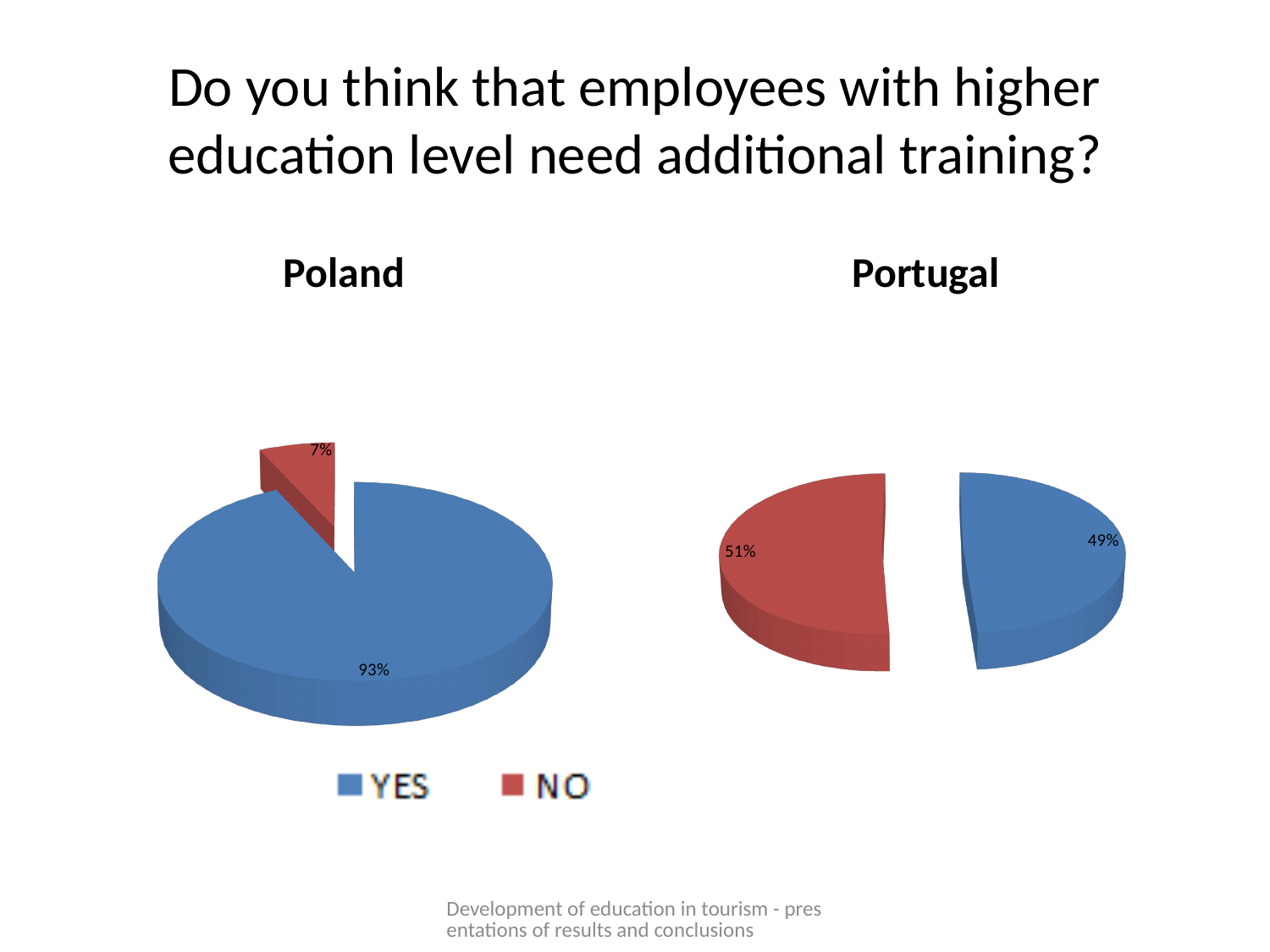
What colour represents the NO answer in the pie charts? Red In the Portugal pie chart, which answer has the smallest share? YES Which is larger: the YES share in the Poland chart or the YES share in the Portugal chart? Poland In the Poland pie chart, what is the difference between the YES and NO shares? 86% In the Poland pie chart, which answer has the largest share? YES In the Portugal pie chart, what is the difference between the NO and YES shares? 2% In the Poland pie chart, what percentage of respondents answered YES? 93% What type of chart is used for the Poland and Portugal data? Pie chart In the Portugal pie chart, what percentage of respondents answered YES? 49% How many categories does the legend list for the pie charts? 2 In the Portugal pie chart, what percentage of respondents answered NO? 51% In the Poland pie chart, what percentage of respondents answered NO? 7%